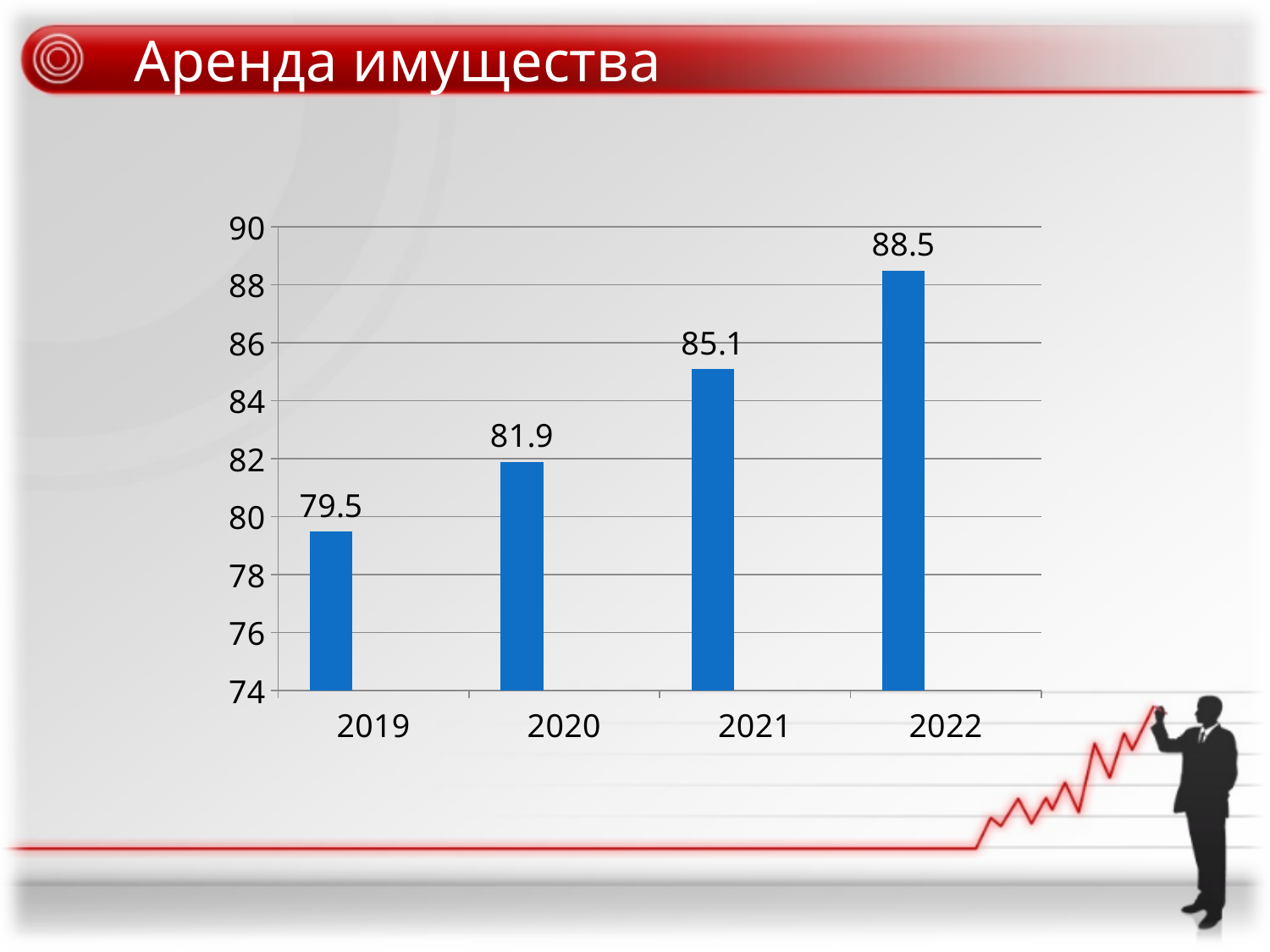
What is the value for 2021? 85.1 What kind of chart is shown on the slide? bar chart What is the value for 2022? 88.5 Which is larger, the value for 2020 or the value for 2021? 2021 Is the value for 2020 greater or less than 80? greater What is the value for 2019? 79.5 Which year has the highest value? 2022 What is the difference between the values for 2021 and 2020? 3.2 Which year has the lowest value? 2019 How many years are shown on the x axis? 4 Do the values rise or fall from 2019 to 2022? rise What is the difference between the values for 2022 and 2019? 9